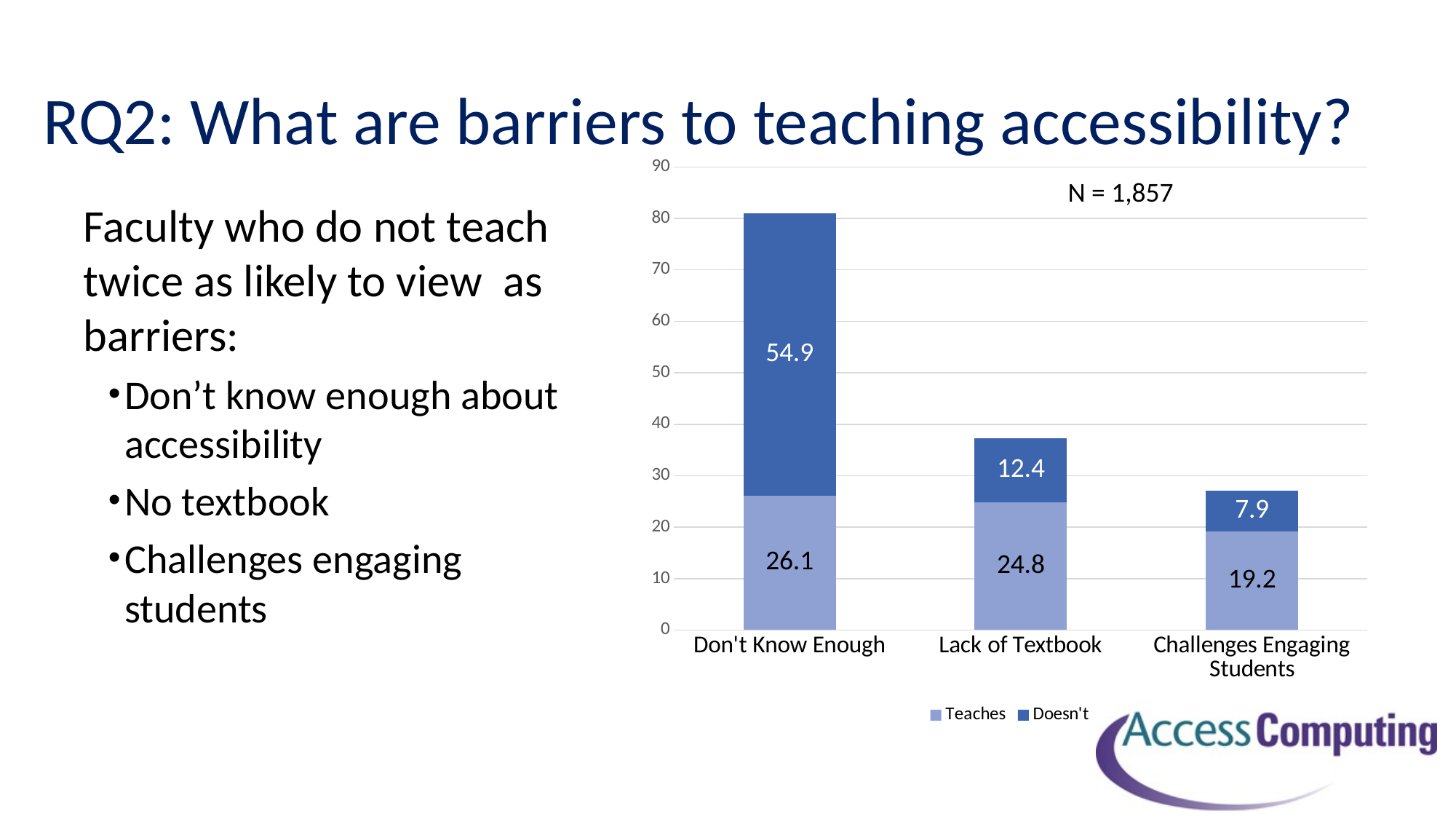
What is the value for Teaches in the Don't Know Enough category? 26.1 What is the value for Doesn't in the Challenges Engaging Students category? 7.9 How many series does the legend list? 2 What is the value for Doesn't in the Lack of Textbook category? 12.4 What is the total of the stacked bar for Don't Know Enough? 81.0 How many categories are shown on the x axis? 3 What is the difference between the Doesn't and Teaches values in the Don't Know Enough category? 28.8 What kind of chart is shown on the slide? Stacked bar chart Which category has the highest value for the Doesn't series? Don't Know Enough Which is larger in the Lack of Textbook category, Teaches or Doesn't? Teaches What is the total of the stacked bar for Lack of Textbook? 37.2 Which category has the lowest value for the Teaches series? Challenges Engaging Students